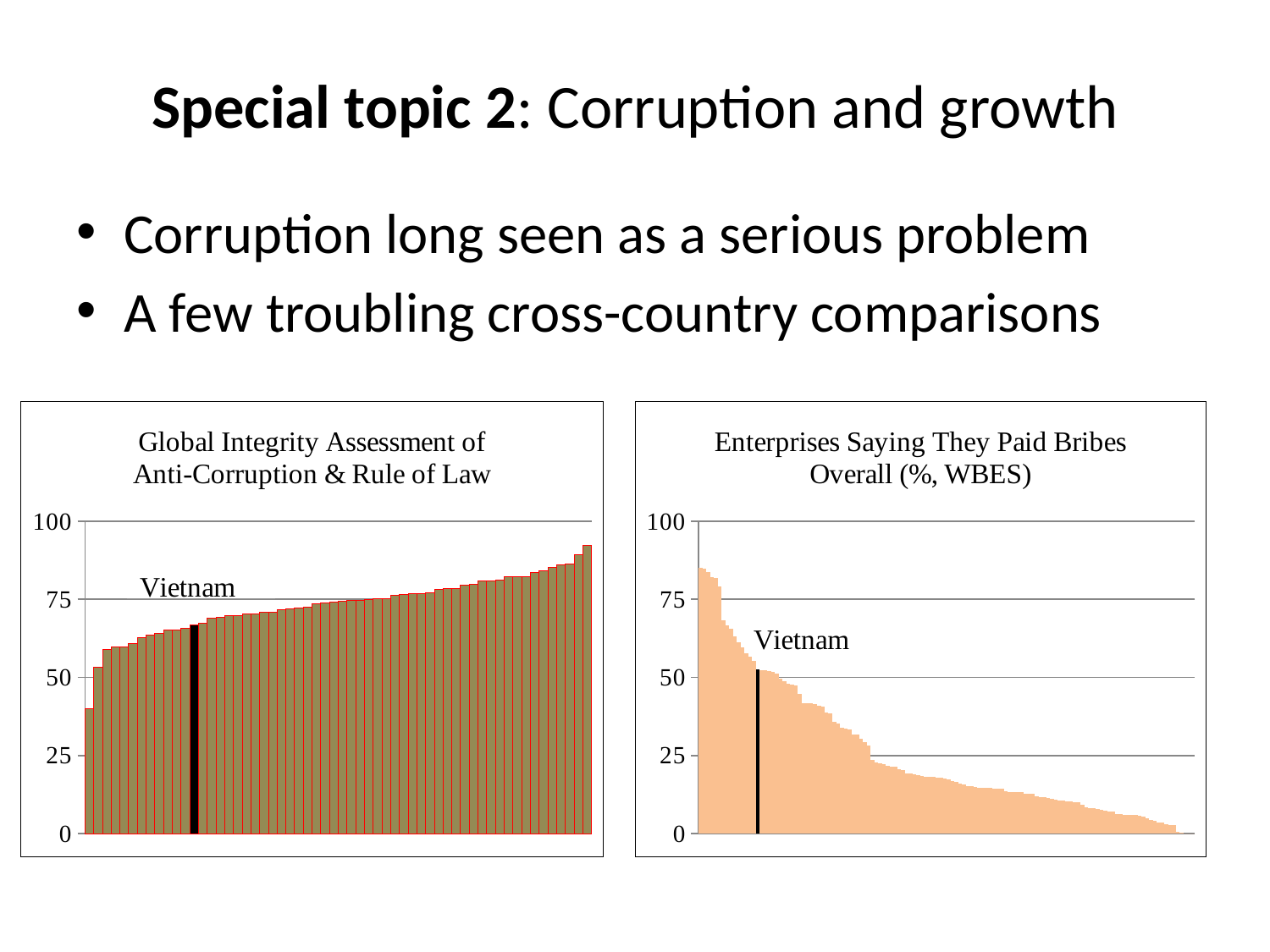
What kind of chart is the chart titled "Global Integrity Assessment of Anti-Corruption & Rule of Law"? bar chart In the right chart (Enterprises Saying They Paid Bribes), is the value for Vietnam greater or less than 25? greater In the left chart (Global Integrity Assessment), do the bar values rise or fall from left to right? rise What is the title of the chart on the right side of the slide? Enterprises Saying They Paid Bribes Overall (%, WBES) In the right chart (Enterprises Saying They Paid Bribes), do the bar values rise or fall from left to right? fall In the left chart (Global Integrity Assessment), is the value for Vietnam greater or less than 75? less In the right chart (Enterprises Saying They Paid Bribes), is the value for Vietnam greater or less than 75? less Which country is highlighted with a black bar in both charts on the slide? Vietnam What kind of chart is the chart titled "Enterprises Saying They Paid Bribes Overall (%, WBES)"? bar chart